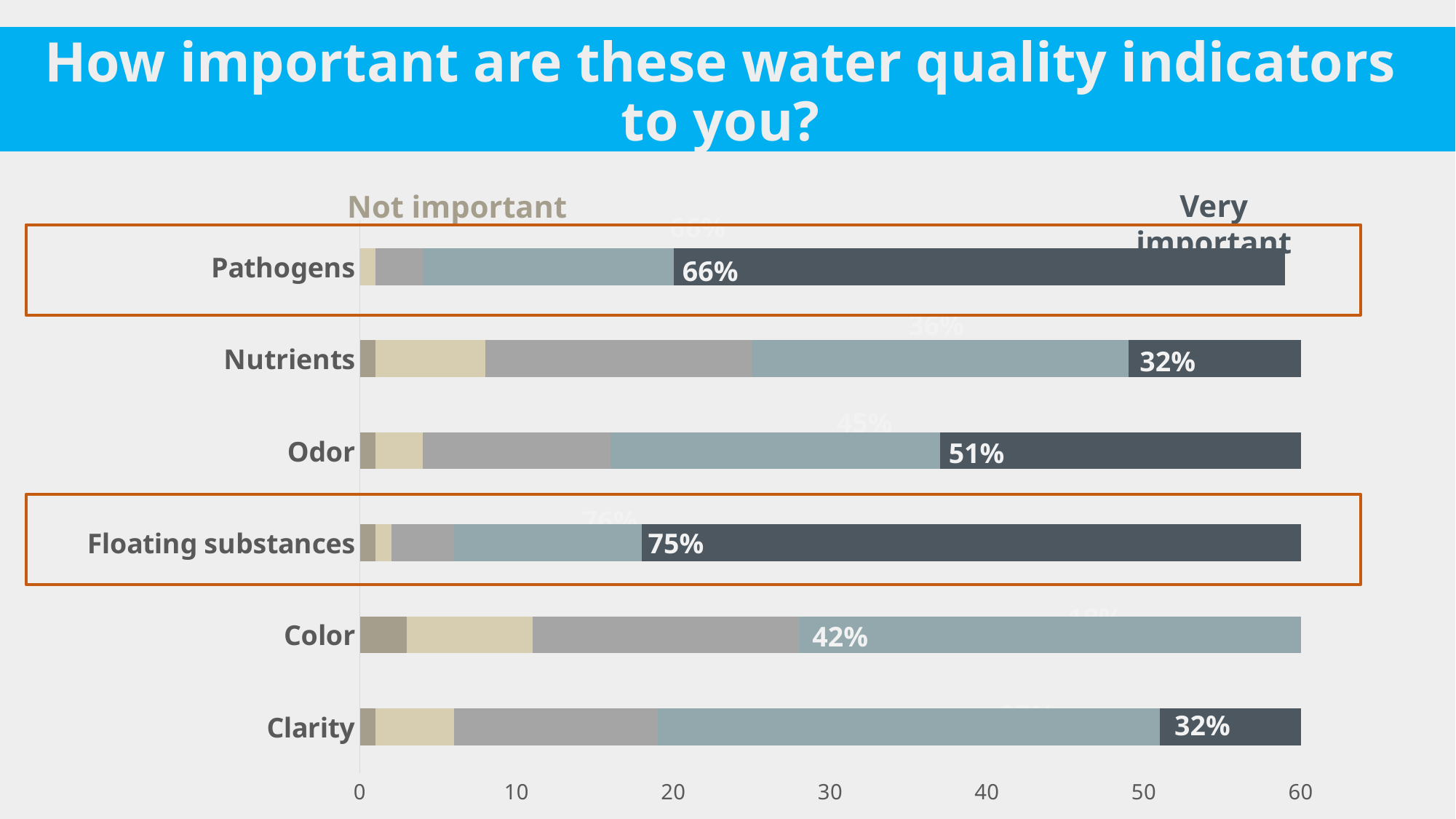
What kind of chart is shown on the slide? Stacked bar chart What is the title of the slide? How important are these water quality indicators to you? What percentage is labeled on the dark 'Very important' segment of the Odor bar? 51% What is the difference between the labeled 'Very important' percentages for Floating substances and Pathogens? 9% Which two indicators are highlighted with orange boxes? Pathogens and Floating substances Which indicator has the highest labeled 'Very important' percentage? Floating substances Which has a larger labeled 'Very important' percentage, Odor or Nutrients? Odor What percentage label is printed on the Color bar? 42% What percentage is labeled on the dark 'Very important' segment of the Floating substances bar? 75% What percentage is labeled on the dark 'Very important' segment of the Pathogens bar? 66% What percentage is labeled on the dark 'Very important' segment of the Nutrients bar? 32% How many water quality indicators are shown in the chart? 6